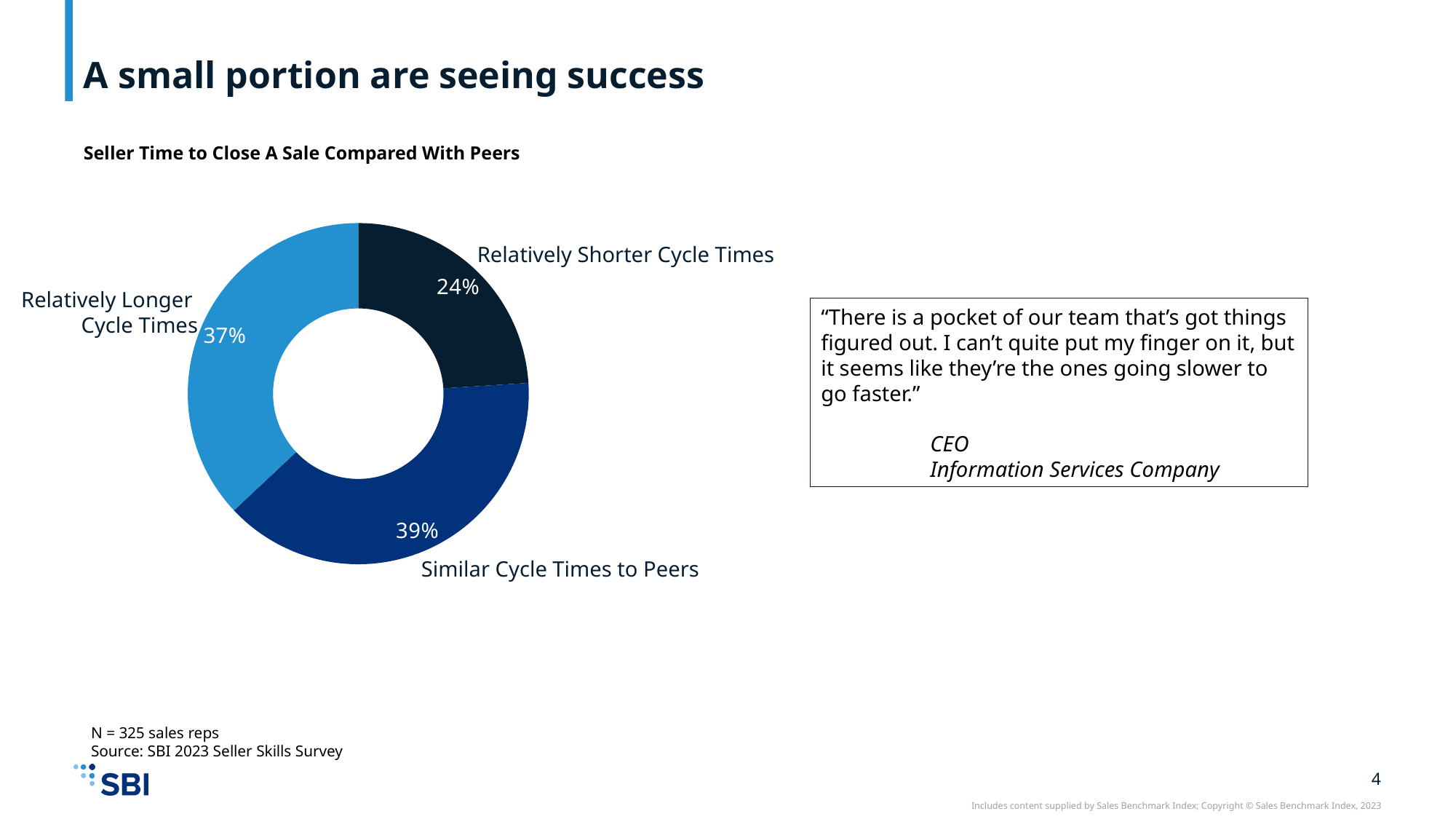
How many categories are shown in the chart? 3 Which category has the largest share of the pie? Similar Cycle Times to Peers What is the difference in percentage points between Similar Cycle Times to Peers and Relatively Shorter Cycle Times? 15 What percentage of sellers have Relatively Longer Cycle Times? 37% What is the title of the chart? Seller Time to Close A Sale Compared With Peers Which category has the smallest share of the pie? Relatively Shorter Cycle Times What percentage of sellers have Relatively Shorter Cycle Times? 24% What kind of chart is shown on the slide? Pie chart (donut) Which is larger: the share for Relatively Longer Cycle Times or Relatively Shorter Cycle Times? Relatively Longer Cycle Times What percentage of sellers have Similar Cycle Times to Peers? 39% What is the difference in percentage points between Relatively Longer Cycle Times and Relatively Shorter Cycle Times? 13 What is the sample size (N) stated below the chart? 325 sales reps